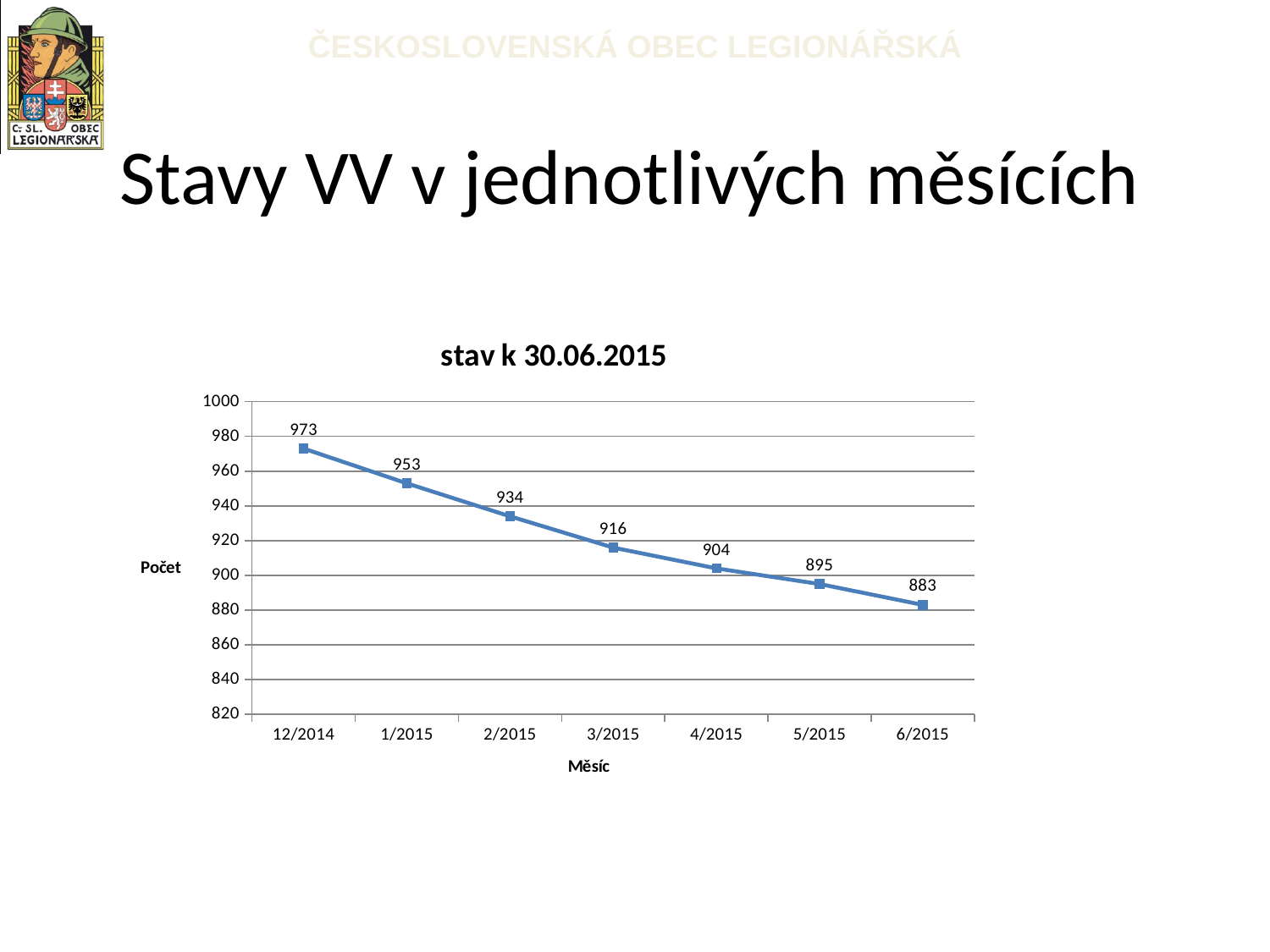
What is the value for 6/2015? 883 What kind of chart is shown on the slide? line chart What is the value for 12/2014? 973 Do the values rise or fall from 12/2014 to 6/2015? fall How many months are plotted on the chart? 7 Which month has the highest value? 12/2014 Which month has the lowest value? 6/2015 Is the value for 2/2015 greater or less than 920? greater What is the difference between the values for 12/2014 and 6/2015? 90 What is the difference between the values for 1/2015 and 2/2015? 19 What is the value for 3/2015? 916 Which is larger, the value for 4/2015 or the value for 5/2015? 4/2015